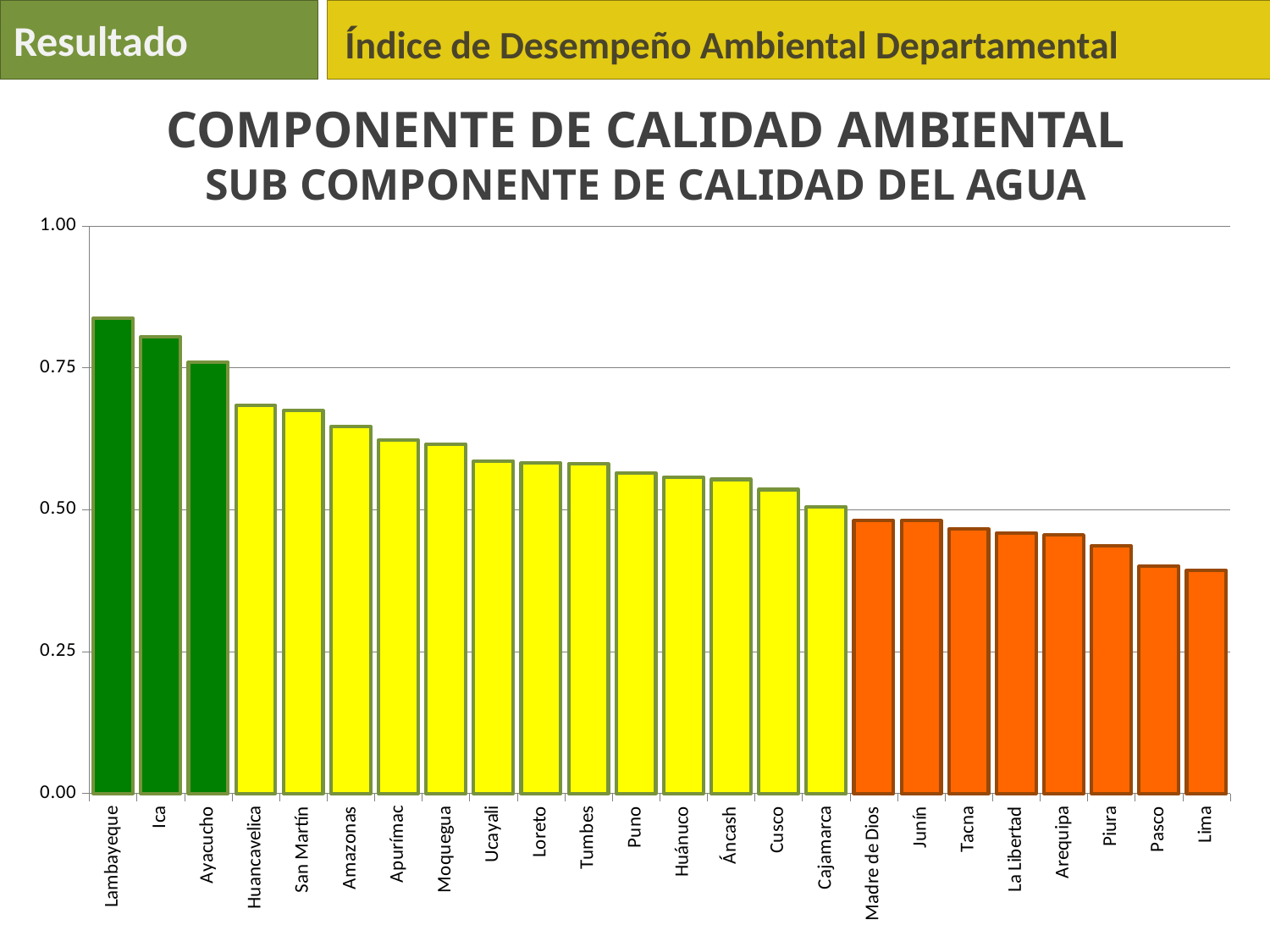
Is the value for Piura greater or less than 0.50? less Is the value for Lima greater or less than 0.50? less How many bars in the chart are coloured dark green? 3 How many departments are shown on the x axis of the chart? 24 Which department has the lowest value in the chart? Lima Do the values rise or fall moving from left to right along the x axis? fall Which department has the highest value in the chart? Lambayeque What kind of chart is shown on the slide? bar chart Is the value for Huancavelica greater or less than 0.75? less Which has a larger value, Amazonas or Pasco? Amazonas Which has a larger value, Ayacucho or Huancavelica? Ayacucho